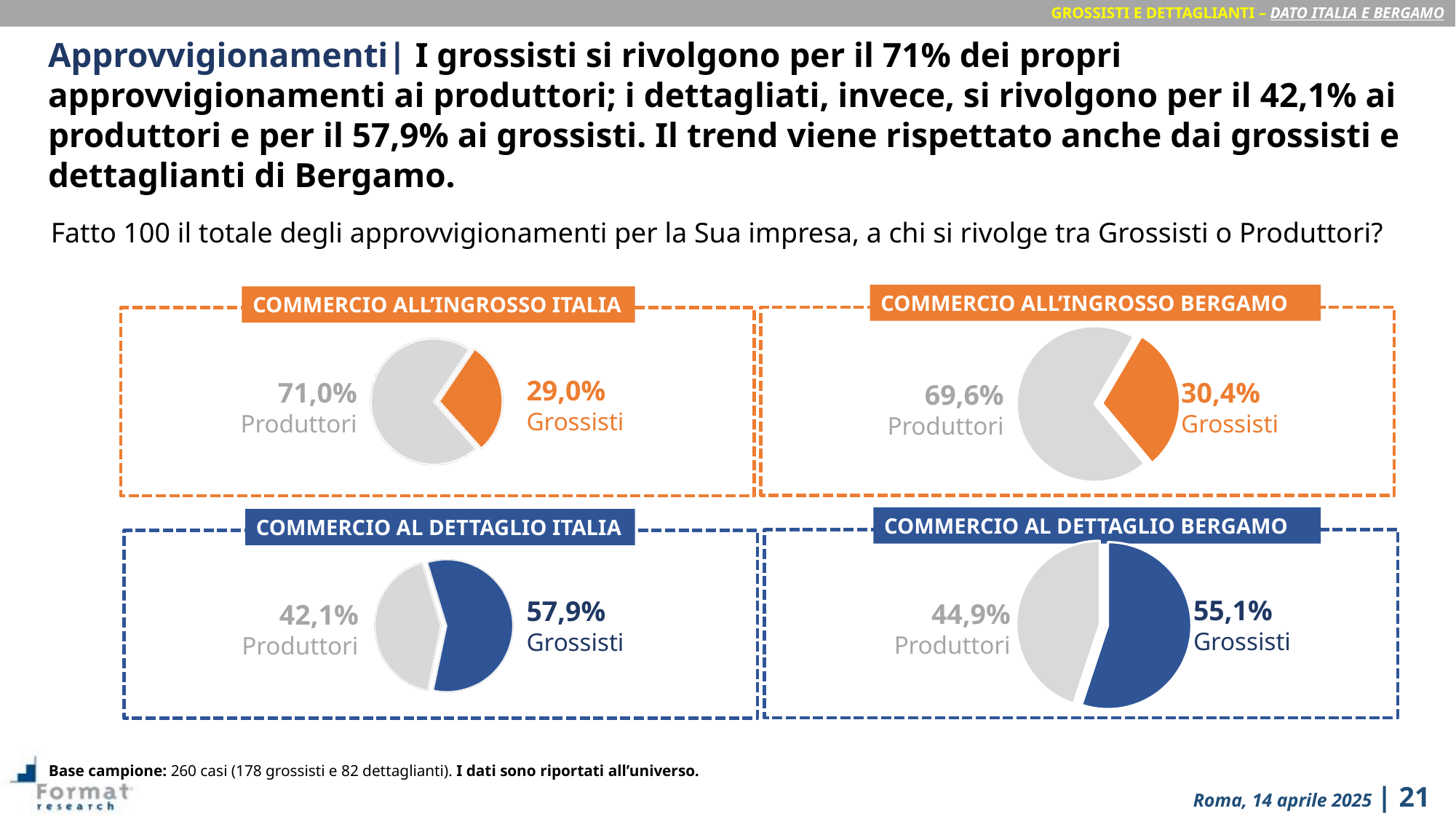
In the 'COMMERCIO ALL'INGROSSO ITALIA' chart, what is the difference between the Produttori and Grossisti shares? 42,0% In the 'COMMERCIO AL DETTAGLIO BERGAMO' chart, what is the value for Grossisti? 55,1% How many slices does the 'COMMERCIO ALL'INGROSSO BERGAMO' pie chart have? 2 How many pie charts are shown on the slide? 4 In the 'COMMERCIO AL DETTAGLIO ITALIA' chart, what is the value for Produttori? 42,1% What kind of chart is used in the 'COMMERCIO AL DETTAGLIO ITALIA' panel? Pie chart In the 'COMMERCIO ALL'INGROSSO BERGAMO' chart, which category has the largest share? Produttori In the 'COMMERCIO AL DETTAGLIO ITALIA' chart, which category has the smallest share? Produttori In the 'COMMERCIO ALL'INGROSSO BERGAMO' chart, what is the value for Grossisti? 30,4% In the 'COMMERCIO AL DETTAGLIO BERGAMO' chart, which is larger, Produttori or Grossisti? Grossisti In the 'COMMERCIO ALL'INGROSSO ITALIA' chart, what is the value for Grossisti? 29,0% In the 'COMMERCIO ALL'INGROSSO ITALIA' chart, what is the value for Produttori? 71,0%